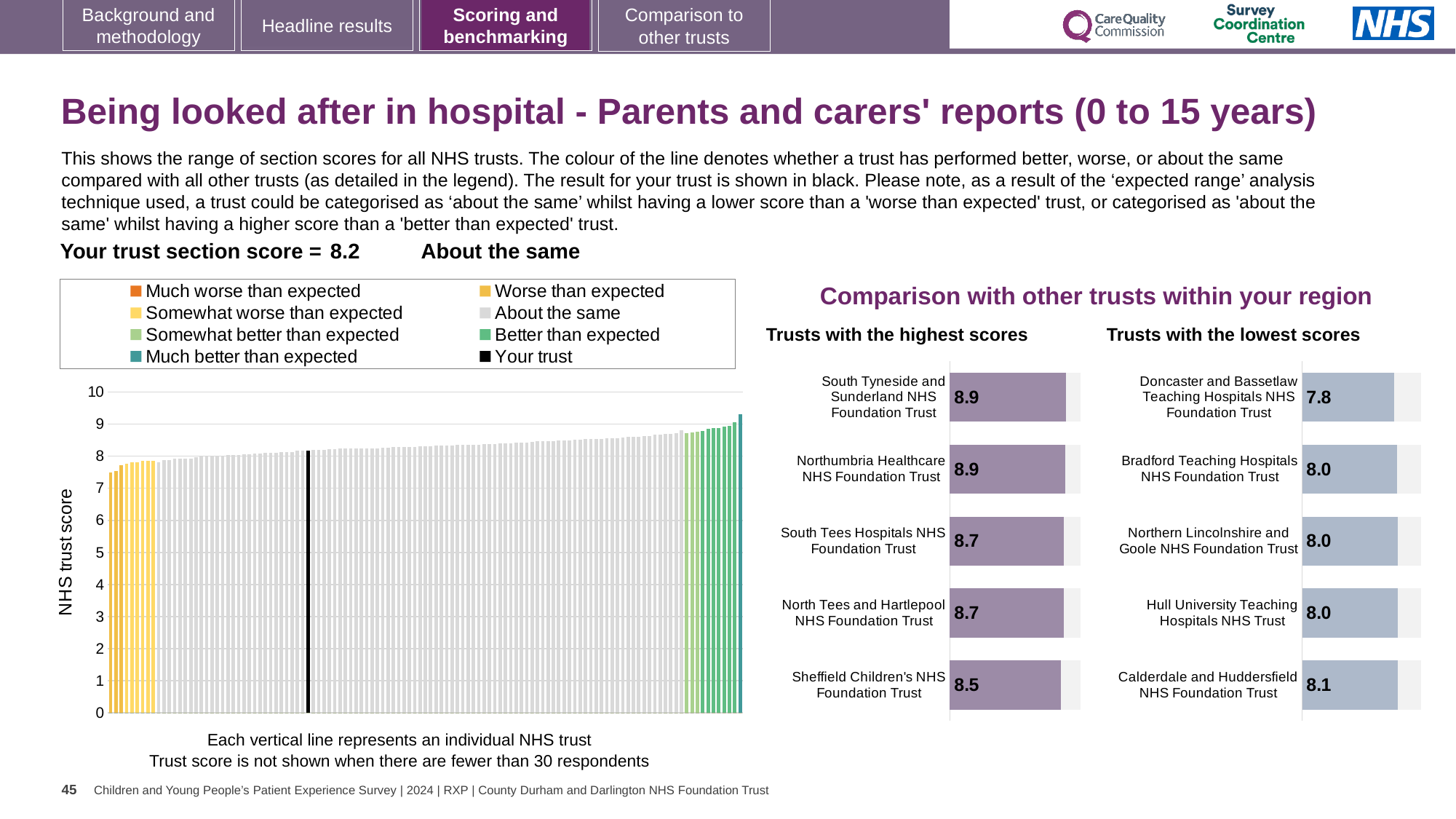
Which has a higher score: Sheffield Children's NHS Foundation Trust in the highest scores chart or Calderdale and Huddersfield NHS Foundation Trust in the lowest scores chart? Sheffield Children's NHS Foundation Trust How many trusts are listed in the 'Trusts with the highest scores' chart? 5 In the 'Trusts with the highest scores' chart, what is the difference between the scores of South Tyneside and Sunderland NHS Foundation Trust and Sheffield Children's NHS Foundation Trust? 0.4 In the 'Trusts with the lowest scores' chart, which trust has the highest score? Calderdale and Huddersfield NHS Foundation Trust In the 'Trusts with the highest scores' chart, what is the score for Sheffield Children's NHS Foundation Trust? 8.5 In the main chart on the left, is the value of the tallest bar greater or less than 9? greater How many entries does the legend of the main chart on the left list? 8 In the main chart on the left, do the bar values rise or fall from left to right? rise In the 'Trusts with the highest scores' chart, which trust has the lowest score? Sheffield Children's NHS Foundation Trust In the 'Trusts with the lowest scores' chart, which trust has the lowest score? Doncaster and Bassetlaw Teaching Hospitals NHS Foundation Trust In the 'Trusts with the lowest scores' chart, what is the difference between the scores of Calderdale and Huddersfield NHS Foundation Trust and Doncaster and Bassetlaw Teaching Hospitals NHS Foundation Trust? 0.3 In the 'Trusts with the lowest scores' chart, what is the score for Doncaster and Bassetlaw Teaching Hospitals NHS Foundation Trust? 7.8